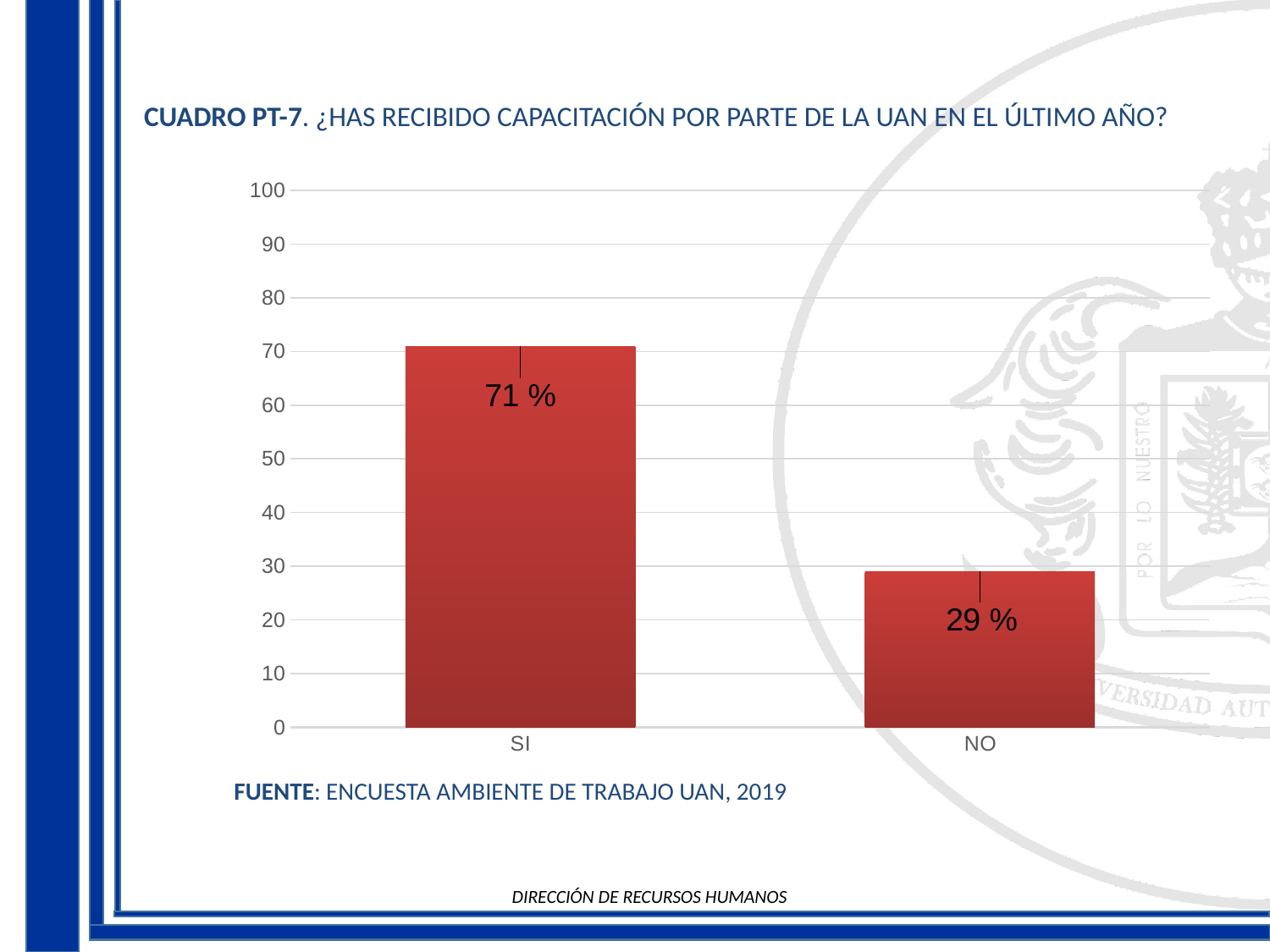
Which category has the lowest value? NO Which is larger, the value for SI or the value for NO? SI Is the value for SI greater or less than 60? greater What kind of chart is shown on the slide? bar chart How many categories are shown on the x axis? 2 Which category has the highest value? SI What is the highest tick value shown on the y axis? 100 What is the value for SI? 71 % What is the value for NO? 29 % Is the value for NO greater or less than 30? less What is the difference between the values for SI and NO? 42 % What source is cited below the chart? ENCUESTA AMBIENTE DE TRABAJO UAN, 2019